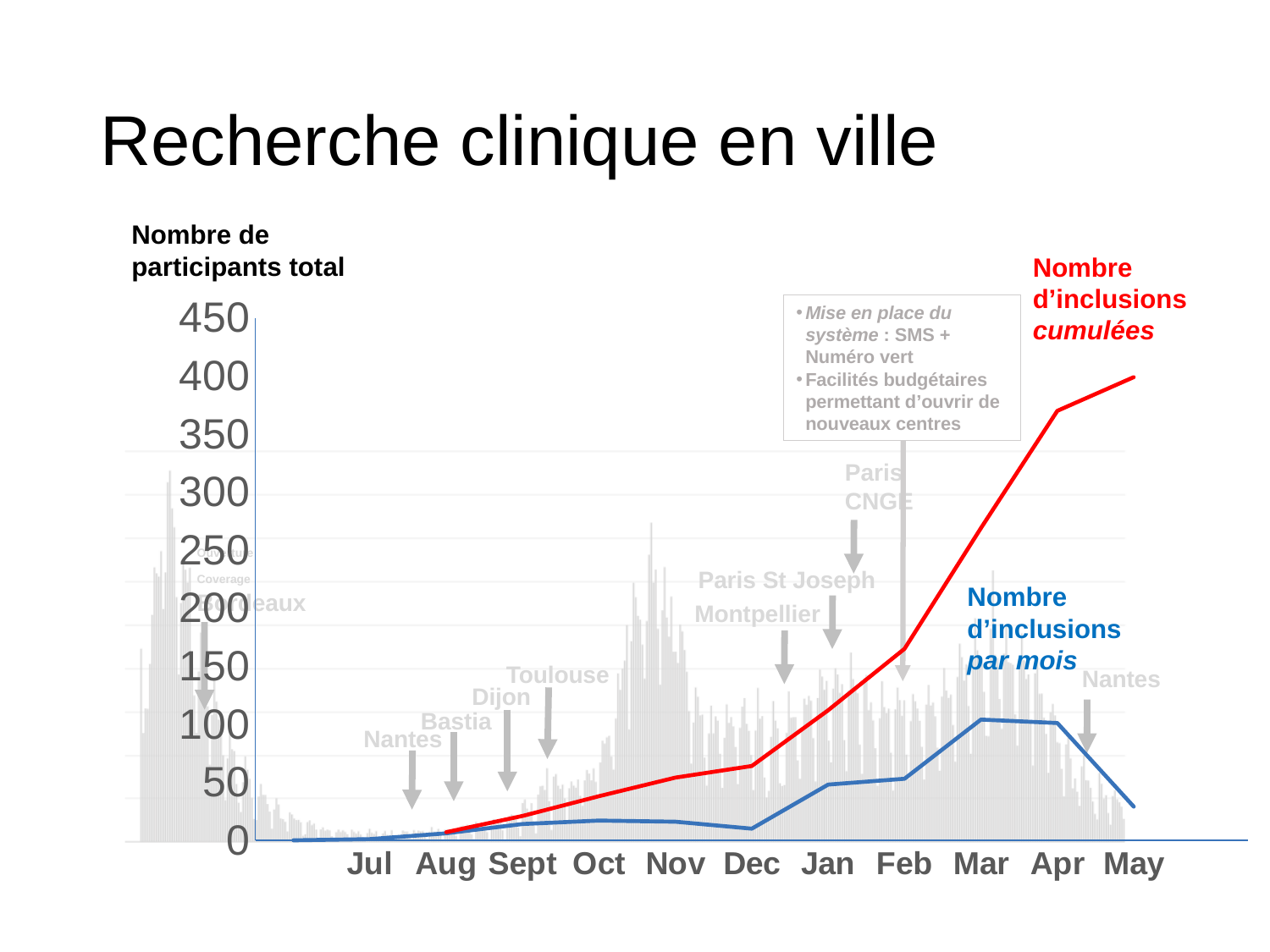
Does the red 'Nombre d'inclusions cumulées' line rise or fall from Jul to May? rise In May, which line is higher: the red 'Nombre d'inclusions cumulées' or the blue 'Nombre d'inclusions par mois'? Nombre d'inclusions cumulées Is the value of the red 'Nombre d'inclusions cumulées' line in Dec greater or less than 100? less Is the value of the blue 'Nombre d'inclusions par mois' line in May greater or less than 50? less Which month has the highest value for the red 'Nombre d'inclusions cumulées' line? May How many series are plotted on the chart? 2 What kind of chart is shown on the slide? line chart Is the value of the red 'Nombre d'inclusions cumulées' line in May greater or less than 350? greater What colour is the 'Nombre d'inclusions par mois' line? blue How many months are labelled on the x axis of the chart? 11